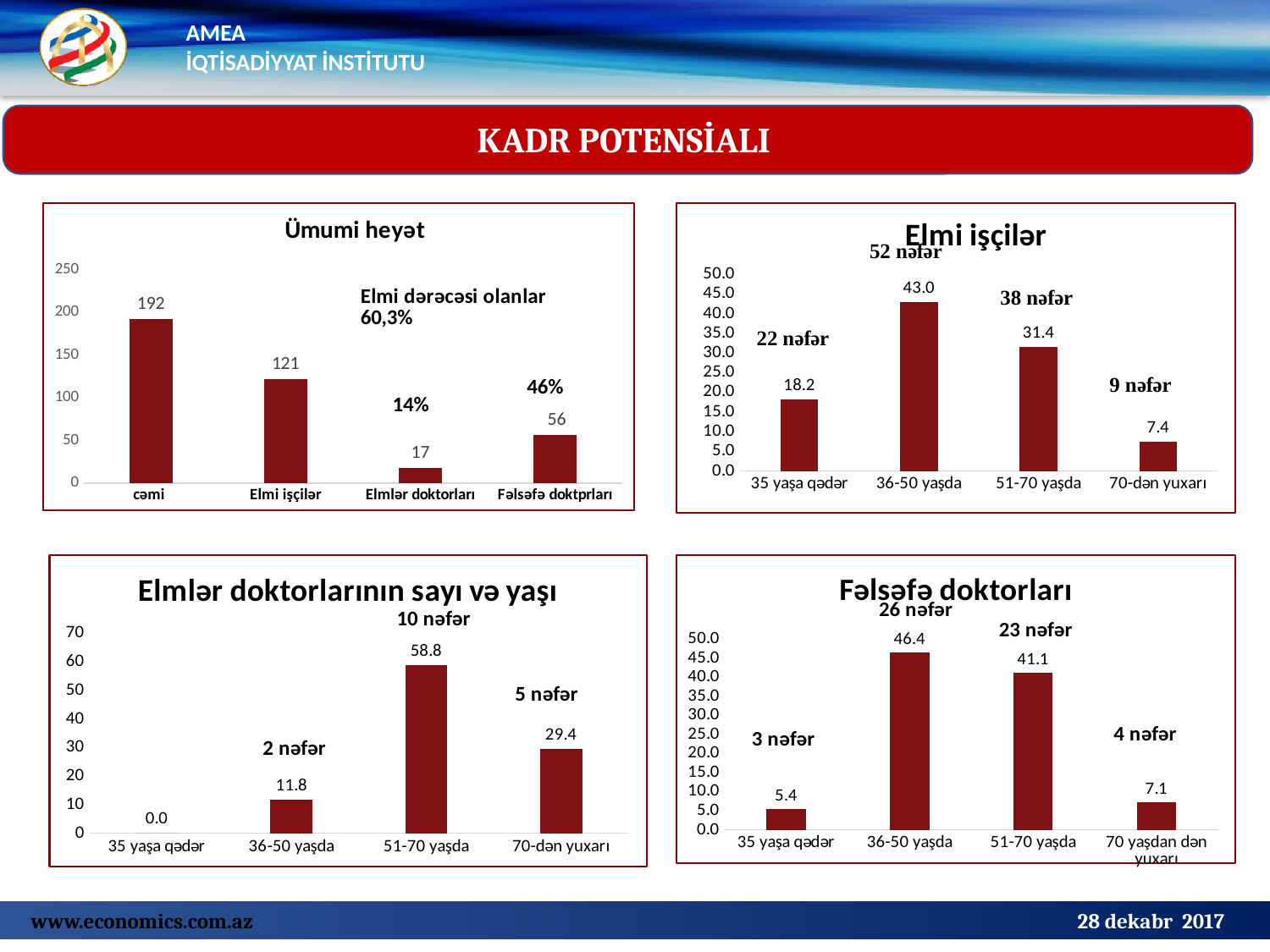
In the 'Elmlər doktorlarının sayı və yaşı' chart, what is the difference between '51-70 yaşda' and '70-dən yuxarı'? 29.4 In the 'Ümumi heyət' chart, what is the value for 'Elmlər doktorları'? 17 What type of chart is the 'Fəlsəfə doktorları' chart? Bar chart In the 'Elmi işçilər' chart, what is the value for '36-50 yaşda'? 43.0 In the 'Ümumi heyət' chart, what is the value for 'cəmi'? 192 In the 'Elmlər doktorlarının sayı və yaşı' chart, what is the value for '51-70 yaşda'? 58.8 In the 'Ümumi heyət' chart, what is the difference between 'Elmi işçilər' and 'Fəlsəfə doktprları'? 65 In the 'Elmi işçilər' chart, which is larger: '35 yaşa qədər' or '51-70 yaşda'? 51-70 yaşda In the 'Fəlsəfə doktorları' chart, what is the value for '35 yaşa qədər'? 5.4 In the 'Ümumi heyət' chart, which category has the lowest value? Elmlər doktorları In the 'Fəlsəfə doktorları' chart, how many age categories are shown? 4 In the 'Elmi işçilər' chart, which age group has the highest value? 36-50 yaşda